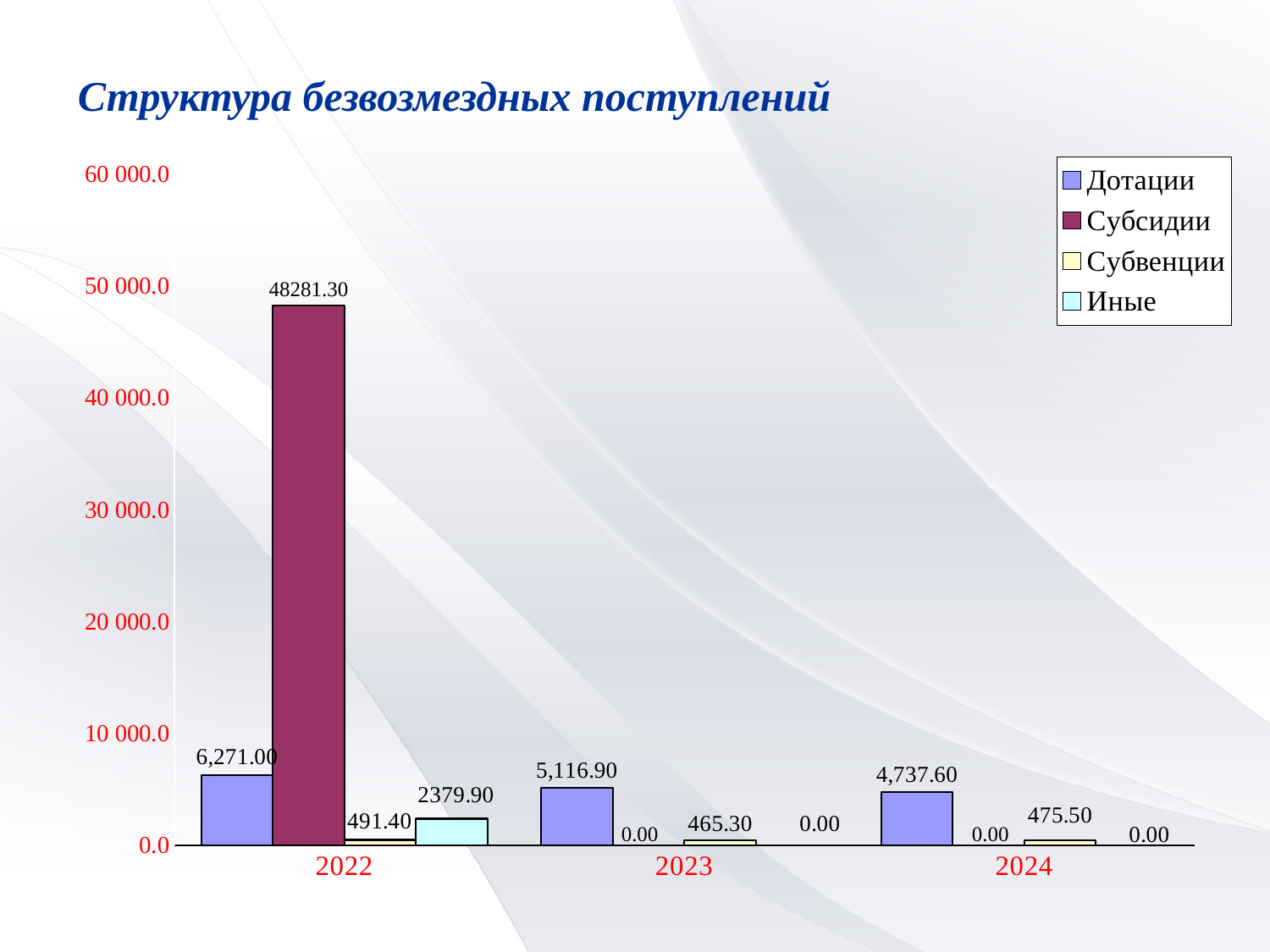
Which series has the highest value in 2022? Субсидии Which is larger: Субвенции in 2023 or Субвенции in 2024? Субвенции in 2024 Which year has the lowest value for Дотации? 2024 What is the value of Субвенции in 2024? 475.50 Do the values for Дотации rise or fall from 2022 to 2024? fall What is the value of Иные in 2022? 2379.90 Is the value for Субсидии in 2022 greater or less than 40 000.0? greater What is the difference between Дотации in 2022 and Дотации in 2023? 1154.10 What is the value of Субсидии in 2022? 48281.30 How many series does the legend list? 4 What kind of chart is shown on the slide? bar chart What is the value of Дотации in 2023? 5,116.90